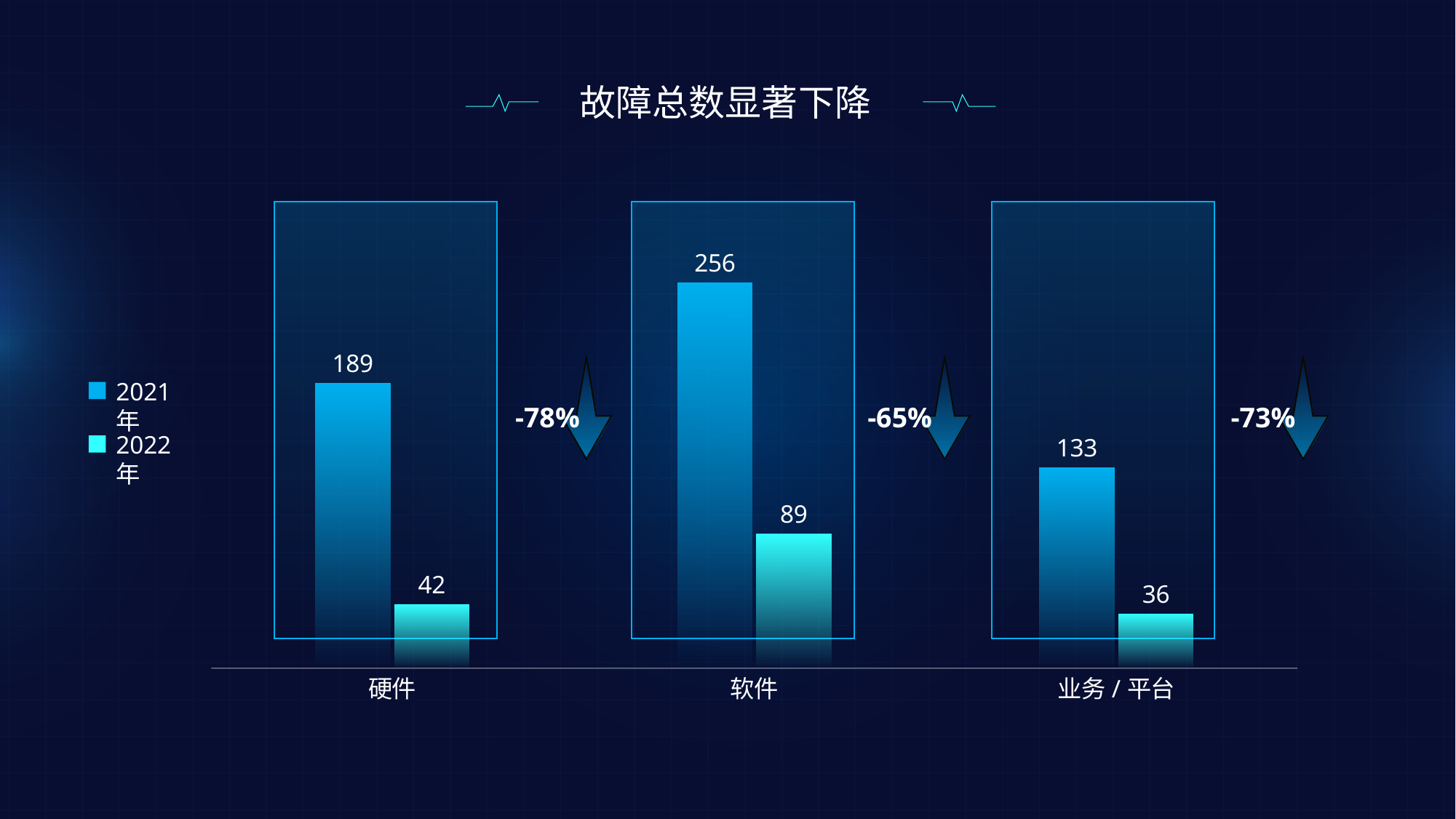
Which category has the highest value in 2021年? 软件 What is the value for 软件 in 2022年? 89 Which is larger: the 2022年 value for 软件 or the 2022年 value for 硬件? 软件 What kind of chart is shown on the slide? bar chart What is the value for 硬件 in 2021年? 189 What is the value for 业务 / 平台 in 2021年? 133 How many series does the legend list? 2 How many categories are shown on the x axis? 3 Which category has the lowest value in 2022年? 业务 / 平台 What is the difference between the 2021年 and 2022年 values for 硬件? 147 What is the title of the chart? 故障总数显著下降 What is the value for 业务 / 平台 in 2022年? 36